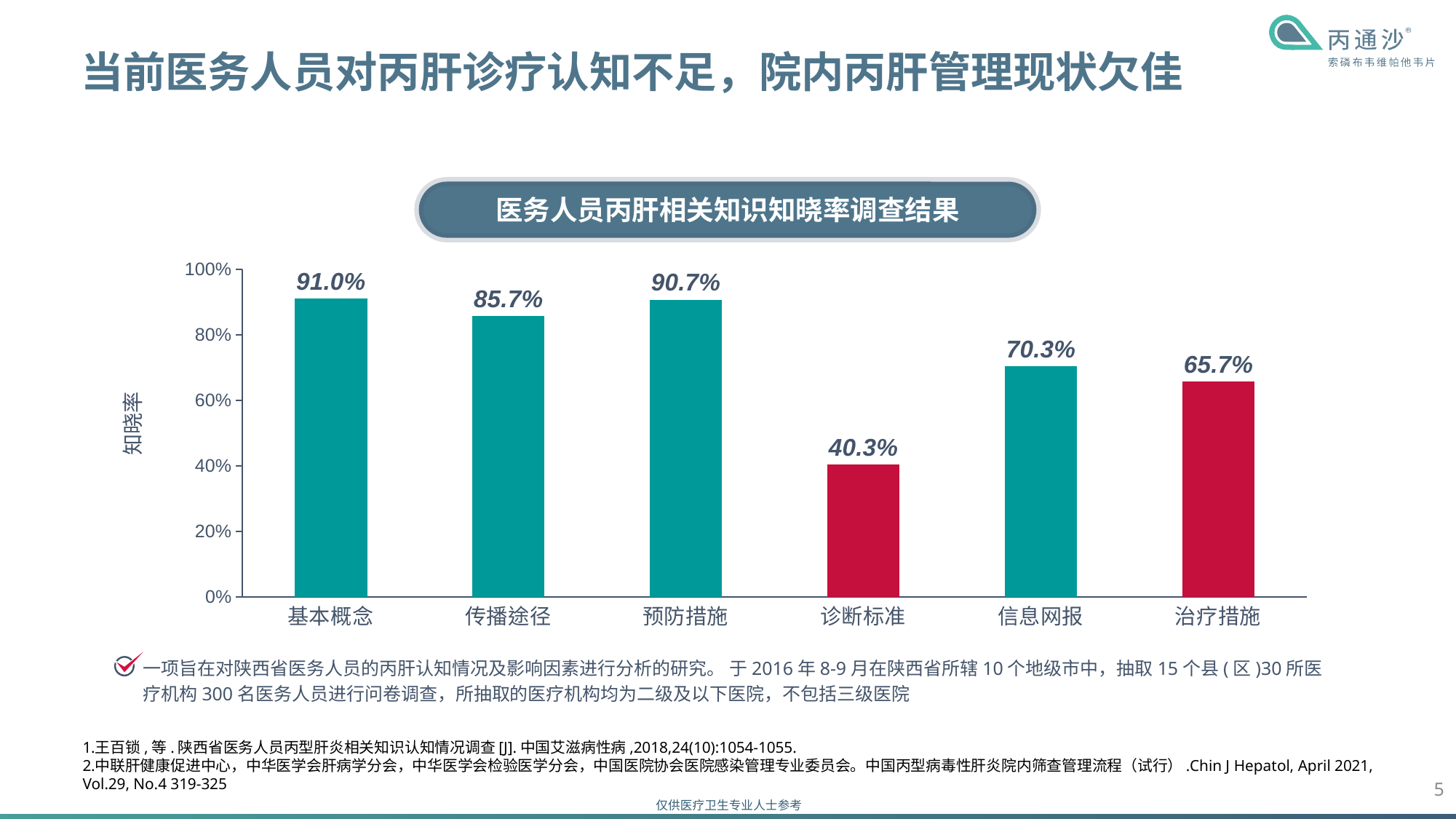
How many categories are shown on the x axis of the chart? 6 What is the awareness rate for 治疗措施? 65.7% What is the difference between the awareness rates for 信息网报 and 治疗措施? 4.6% What is the awareness rate for 诊断标准? 40.3% What is the awareness rate for 信息网报? 70.3% Which category has the highest awareness rate? 基本概念 Which has a higher awareness rate, 传播途径 or 预防措施? 预防措施 Which category has the lowest awareness rate? 诊断标准 What kind of chart is shown on the slide? Bar chart What is the difference between the awareness rates for 基本概念 and 诊断标准? 50.7% What is the awareness rate (知晓率) for 基本概念? 91.0% What is the title of the chart? 医务人员丙肝相关知识知晓率调查结果